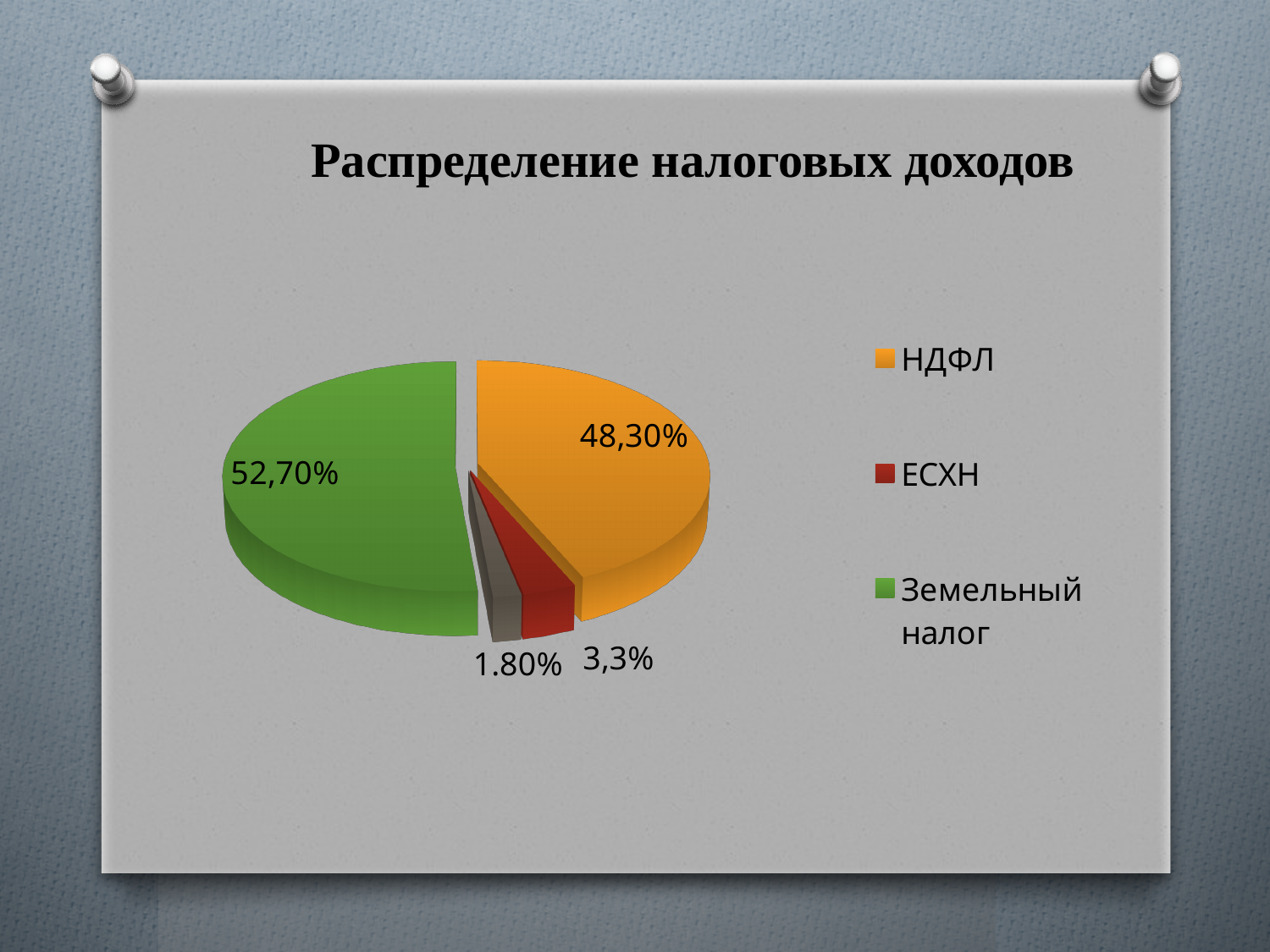
How many entries does the legend list? 3 What kind of chart is shown on the slide? pie chart What share of the pie does НДФЛ have? 48,30% What is the title of the chart? Распределение налоговых доходов What share of the pie does ЕСХН have? 3,3% Which is larger, the share for НДФЛ or the share for Земельный налог? Земельный налог What colour is the slice for ЕСХН? red Which category has the largest slice of the pie? Земельный налог How many slices does the pie chart have? 4 What share of the pie does Земельный налог have? 52,70% Which of the legend categories has the smallest slice of the pie? ЕСХН What is the difference between the share for Земельный налог and the share for НДФЛ? 4,40%